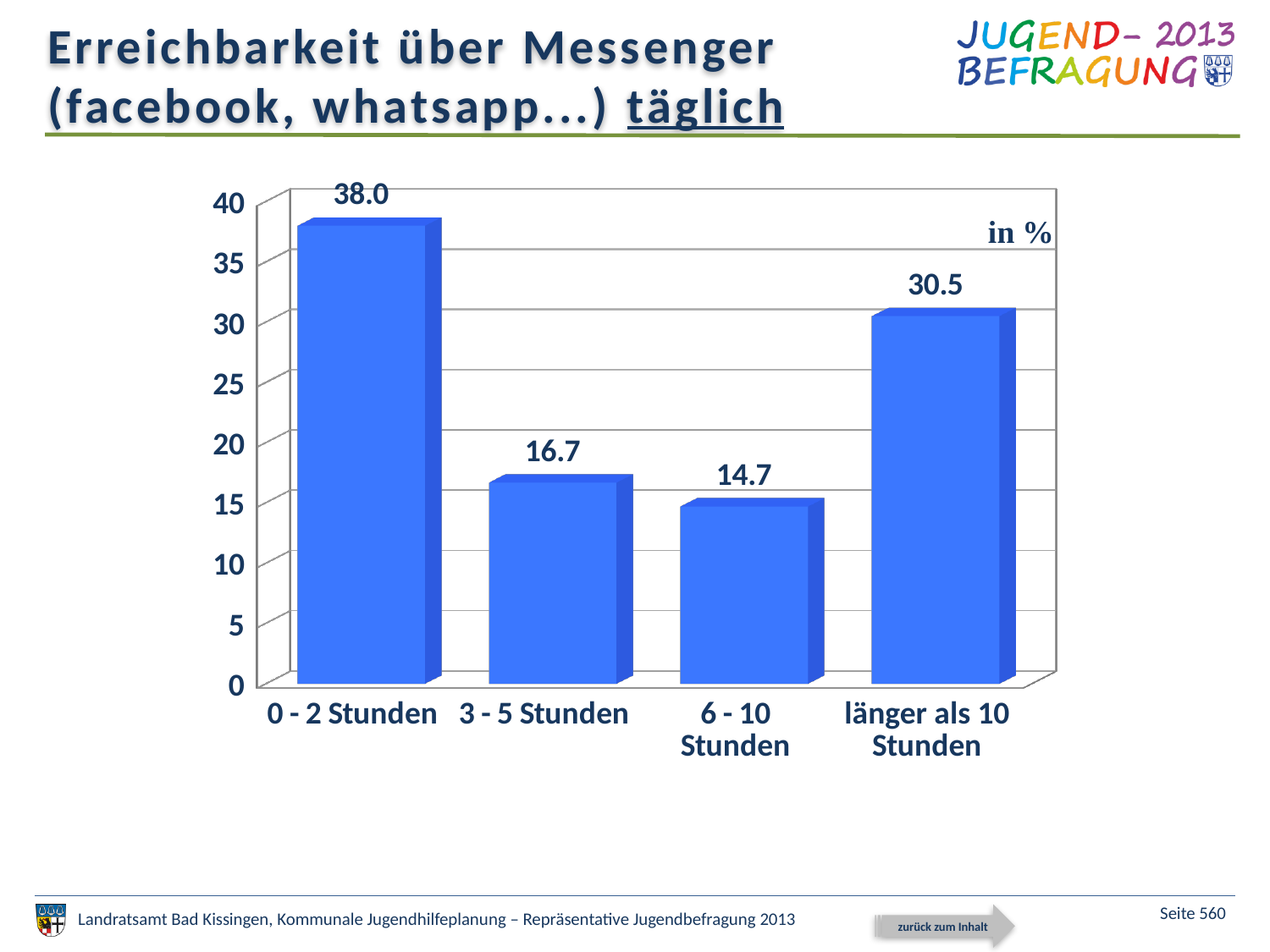
What is the value for "0 - 2 Stunden"? 38.0 What kind of chart is shown on the slide? bar chart Which category has the lowest value? 6 - 10 Stunden What unit is indicated in the top right corner of the chart? in % What is the value for "3 - 5 Stunden"? 16.7 How many categories are shown on the x axis? 4 What is the value for "länger als 10 Stunden"? 30.5 What is the value for "6 - 10 Stunden"? 14.7 What is the difference between the values for "0 - 2 Stunden" and "länger als 10 Stunden"? 7.5 Which category has the highest value? 0 - 2 Stunden Which is larger, the value for "3 - 5 Stunden" or the value for "6 - 10 Stunden"? 3 - 5 Stunden Is the value for "länger als 10 Stunden" greater or less than 25? greater